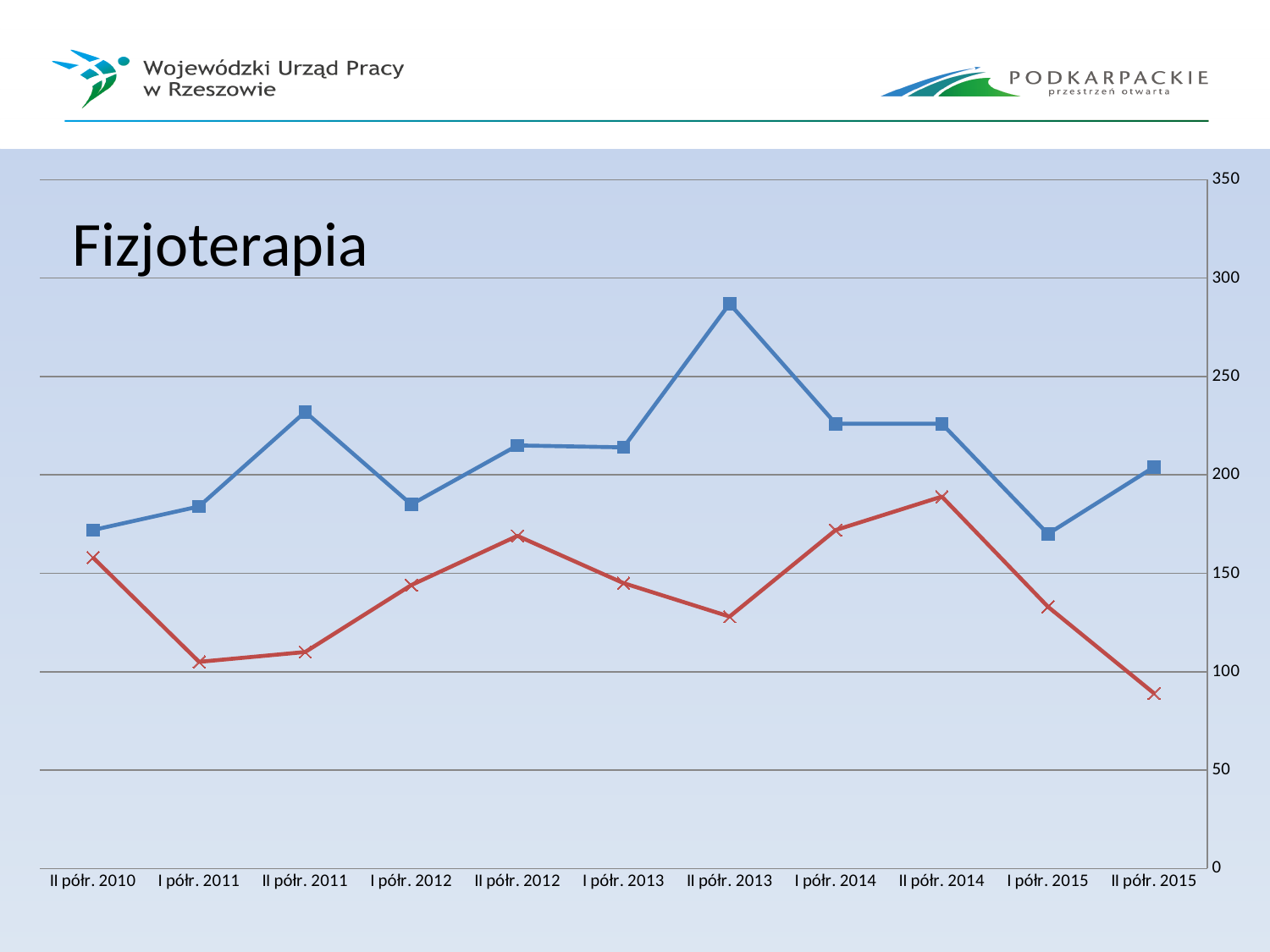
What is the title of the chart? Fizjoterapia At I półr. 2011, which line has the higher value, the blue line or the red line? the blue line Is the value of the red line at II półr. 2015 greater or less than 100? less Is the value of the blue line at II półr. 2013 greater or less than 250? greater In which period does the blue line with square markers reach its highest value? II półr. 2013 Is the value of the blue line at II półr. 2011 greater or less than 200? greater In which period does the red line with x markers reach its lowest value? II półr. 2015 Does the red line rise or fall from II półr. 2014 to II półr. 2015? falls How many periods are shown along the x axis? 11 What kind of chart is shown on the slide? line chart In which period does the red line with x markers reach its highest value? II półr. 2014